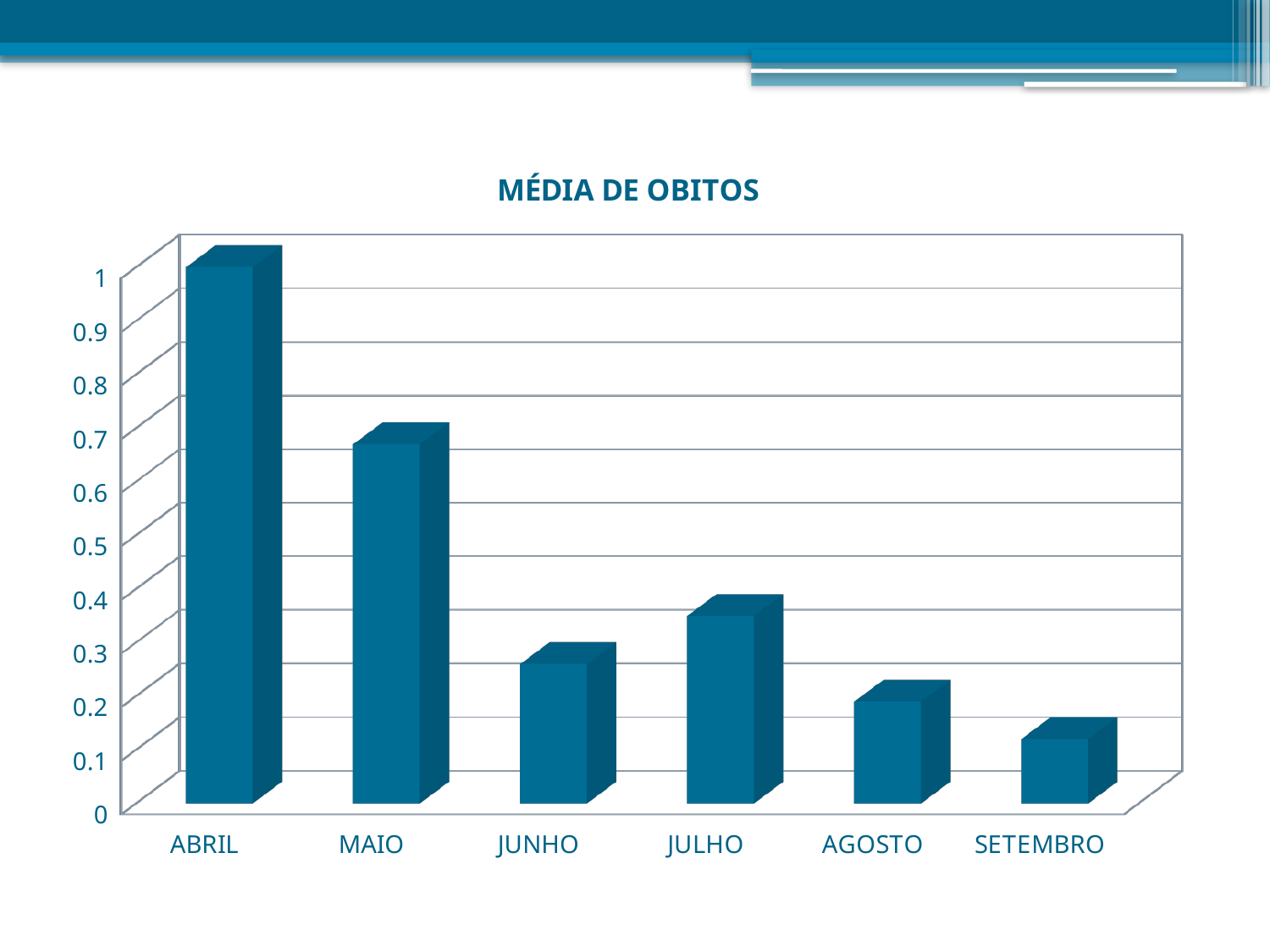
Is the value for SETEMBRO greater or less than 0.2? less Is the value for JUNHO greater or less than 0.4? less Which month has the lowest value in the chart? SETEMBRO What kind of chart is shown on the slide? bar chart Which month has the highest value in the chart? ABRIL Is the value for ABRIL greater or less than 0.8? greater Which is larger, the value for MAIO or the value for JULHO? MAIO How many months are shown on the x axis of the chart? 6 Which is larger, the value for JUNHO or the value for JULHO? JULHO Do the values generally rise or fall from ABRIL to SETEMBRO? fall What is the title of the chart? MÉDIA DE OBITOS